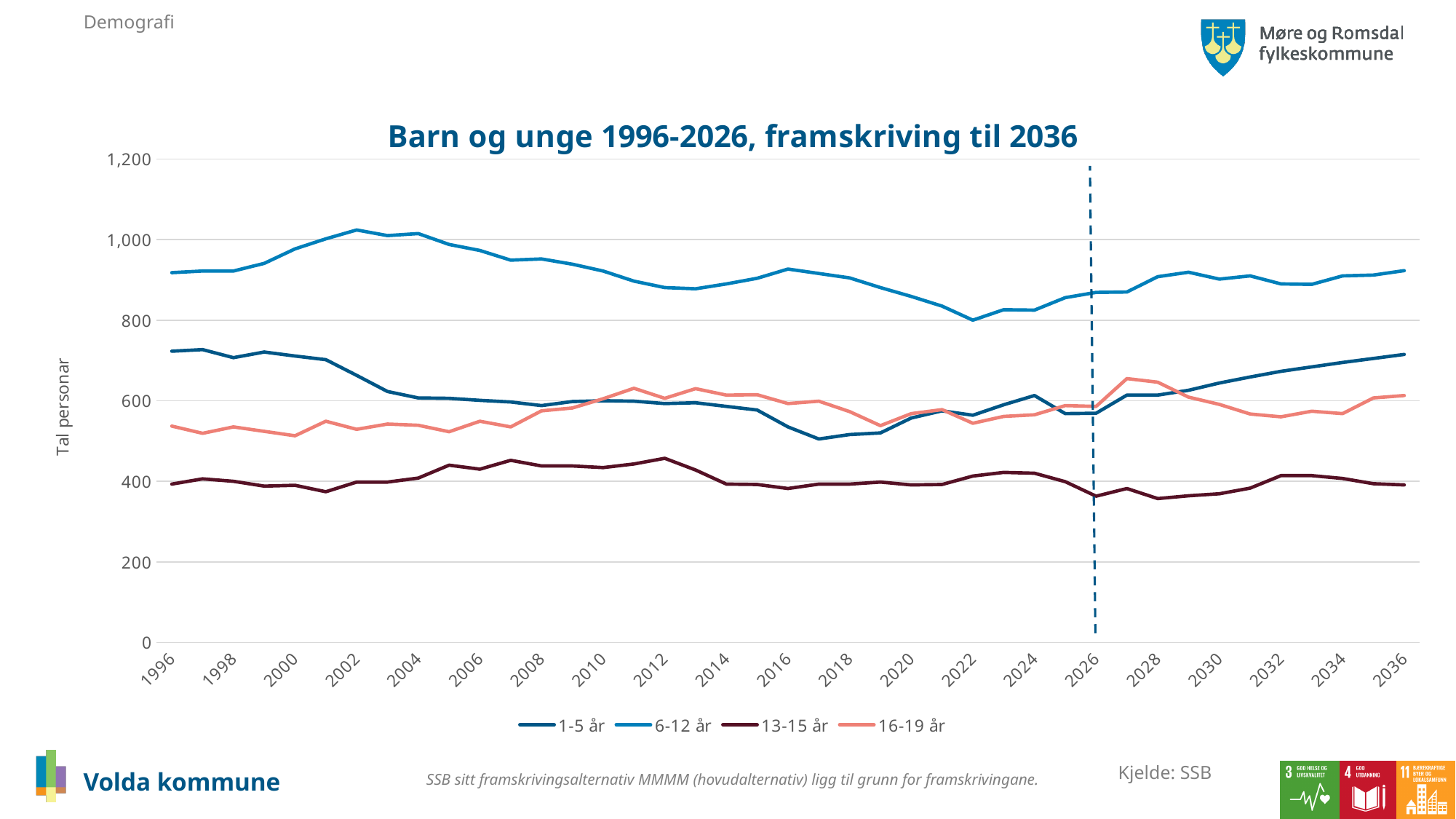
How many series does the legend list? 4 Does the 1-5 år series rise or fall from 2026 to 2036? Rise Is the value for 1-5 år in 2017 greater or less than 600? less Which series has the highest values across the whole chart? 6-12 år What is the title of the chart? Barn og unge 1996-2026, framskriving til 2036 Is the value for 6-12 år in 2002 greater or less than 1,000? greater What is the label on the vertical axis? Tal personar Which series has the lowest values across the whole chart? 13-15 år Is the value for 16-19 år in 2027 greater or less than 600? greater What kind of chart is shown on the slide? Line chart In 2036, which is larger: the value for 1-5 år or the value for 16-19 år? 1-5 år